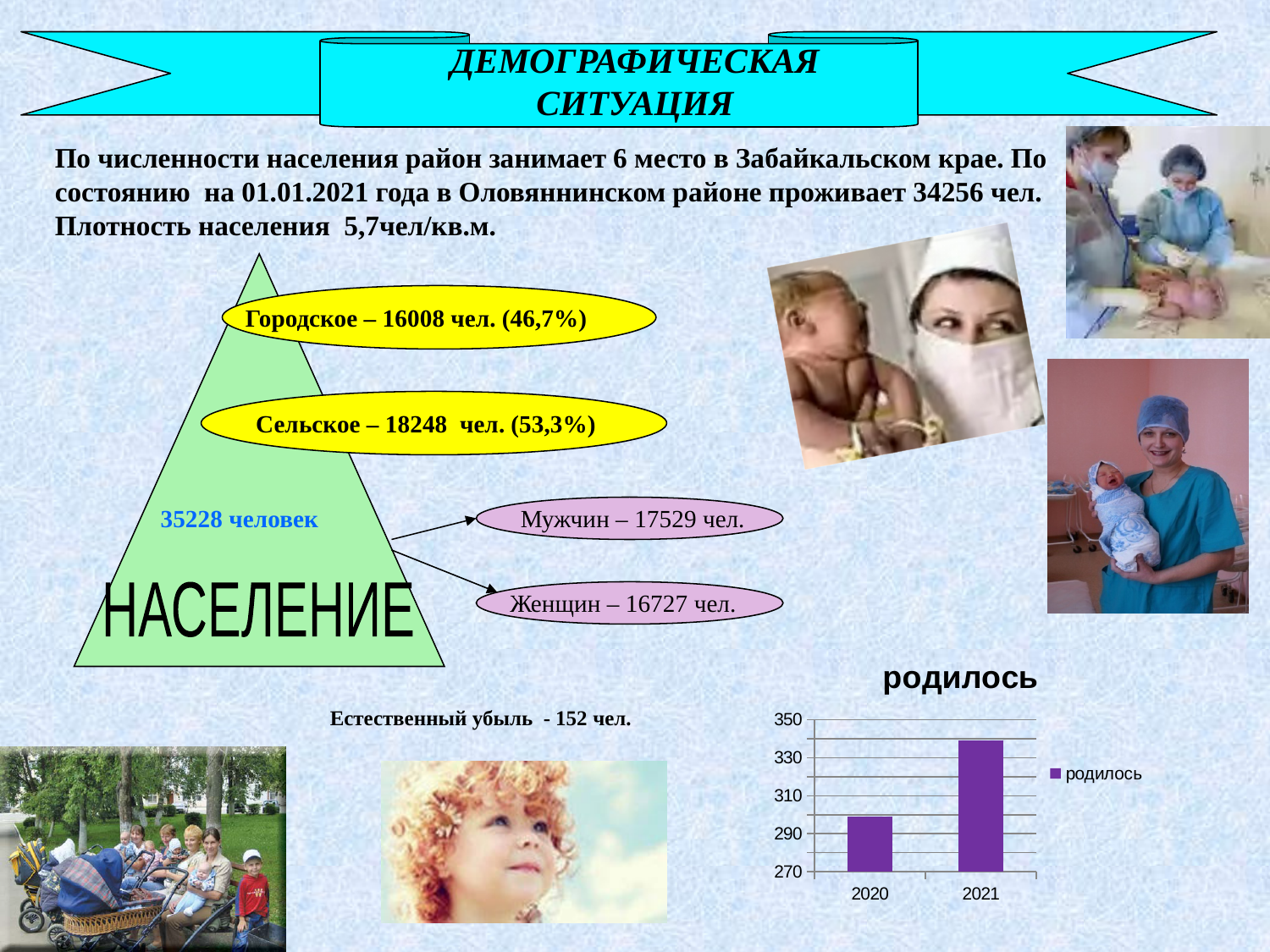
How many series does the legend of the "родилось" chart list? 1 How many categories are shown on the x axis of the "родилось" chart? 2 In the "родилось" chart, is the value for 2020 greater or less than 310? less Which year has the highest value in the "родилось" chart? 2021 What is the title of the bar chart on the slide? родилось In the "родилось" chart, which is larger, the value for 2020 or for 2021? 2021 Which year has the lowest value in the "родилось" chart? 2020 Do the values in the "родилось" chart rise or fall from 2020 to 2021? rise What kind of chart is the "родилось" chart? bar chart In the "родилось" chart, is the value for 2021 greater or less than 330? greater In the "родилось" chart, is the value for 2020 greater or less than 290? greater What is the name of the series listed in the legend of the bar chart? родилось